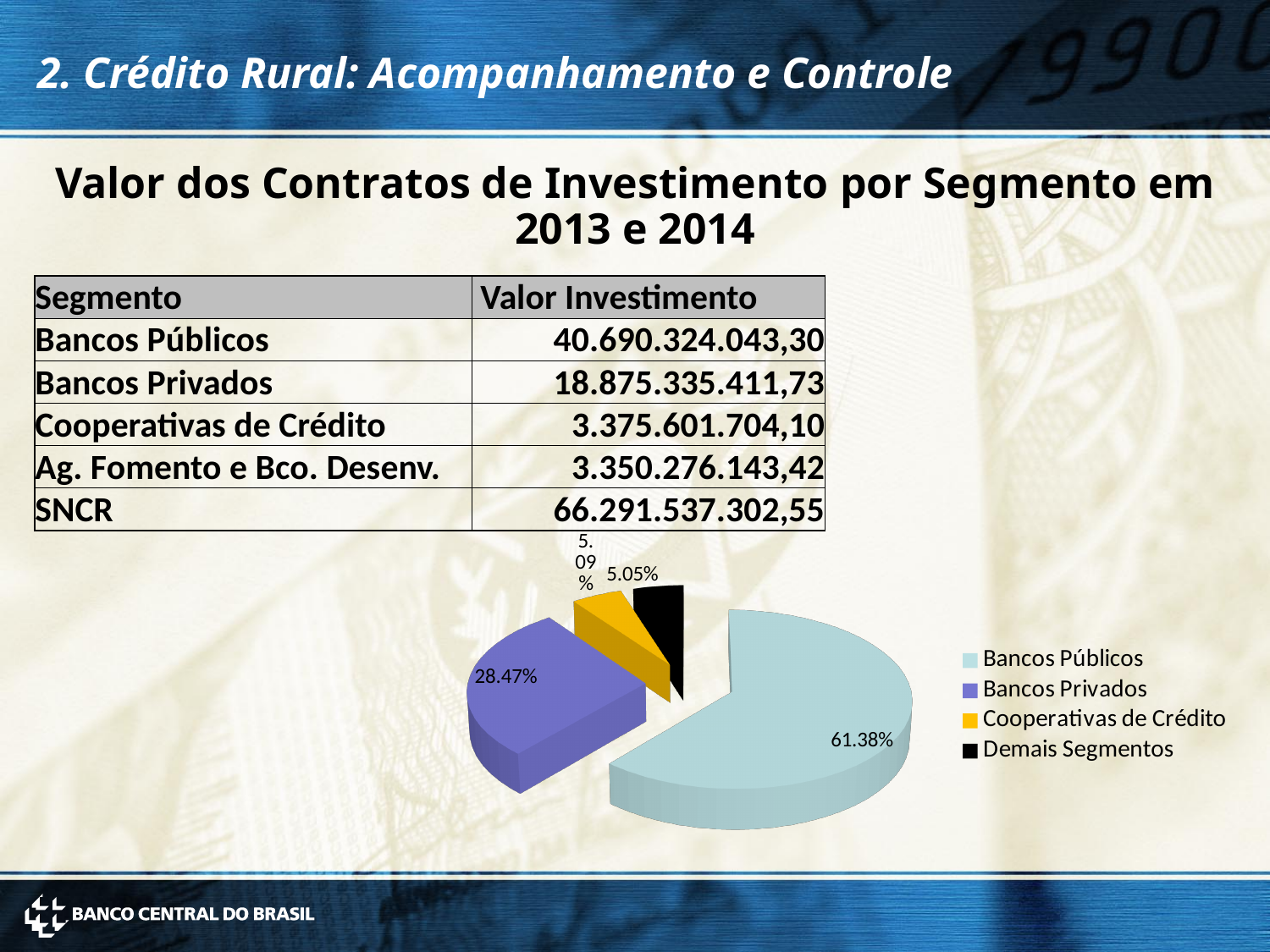
What is the difference in percentage points between the Bancos Públicos slice and the Bancos Privados slice? 32.91 Which segment has the smallest slice of the pie? Demais Segmentos What colour is the Bancos Privados slice in the pie chart? purple What kind of chart is shown on the slide? pie chart How many entries does the chart legend list? 4 What share of the pie does Cooperativas de Crédito hold? 5.09% Which segment has the largest slice of the pie? Bancos Públicos What share of the pie does Demais Segmentos hold? 5.05% Which slice is larger, Bancos Privados or Cooperativas de Crédito? Bancos Privados How many slices does the pie chart have? 4 What share of the pie does Bancos Privados hold? 28.47%